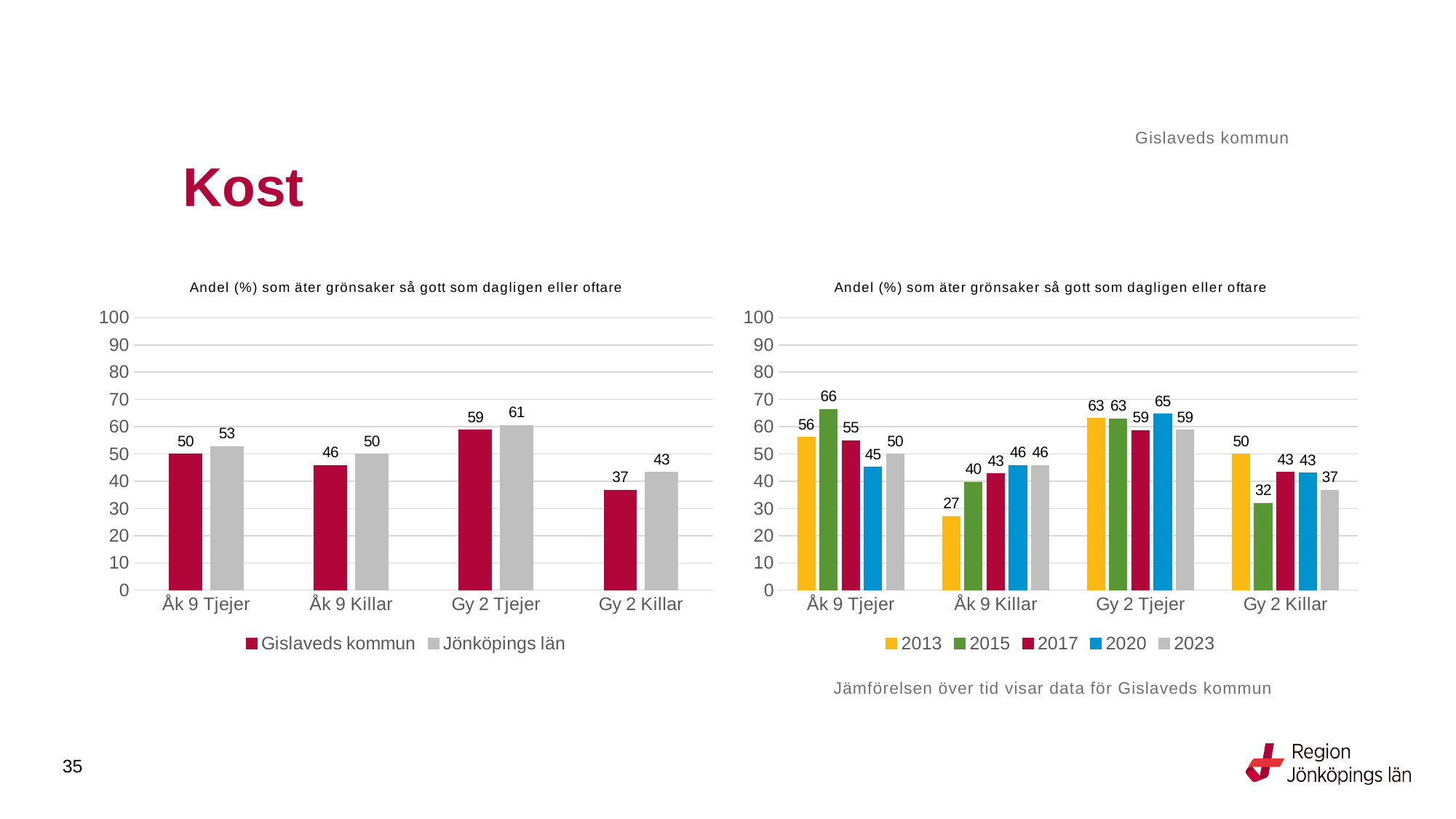
What kind of chart is the left chart? bar chart In the left chart, what is the value for Jönköpings län for Gy 2 Killar? 43 In the right chart, what is the value for 2015 for Åk 9 Tjejer? 66 In the left chart, which category has the lowest value for Gislaveds kommun? Gy 2 Killar In the left chart, what is the difference between Jönköpings län and Gislaveds kommun for Åk 9 Killar? 4 In the left chart, what is the value for Gislaveds kommun for Gy 2 Tjejer? 59 In the right chart, is the value for 2013 for Gy 2 Killar larger or smaller than the value for 2015 for Gy 2 Killar? larger In the right chart, which year has the highest value for Gy 2 Tjejer? 2020 In the right chart, what is the value for 2013 for Åk 9 Killar? 27 In the right chart, how many series does the legend list? 5 In the left chart, how many series does the legend list? 2 In the right chart, how many categories are shown on the x axis? 4